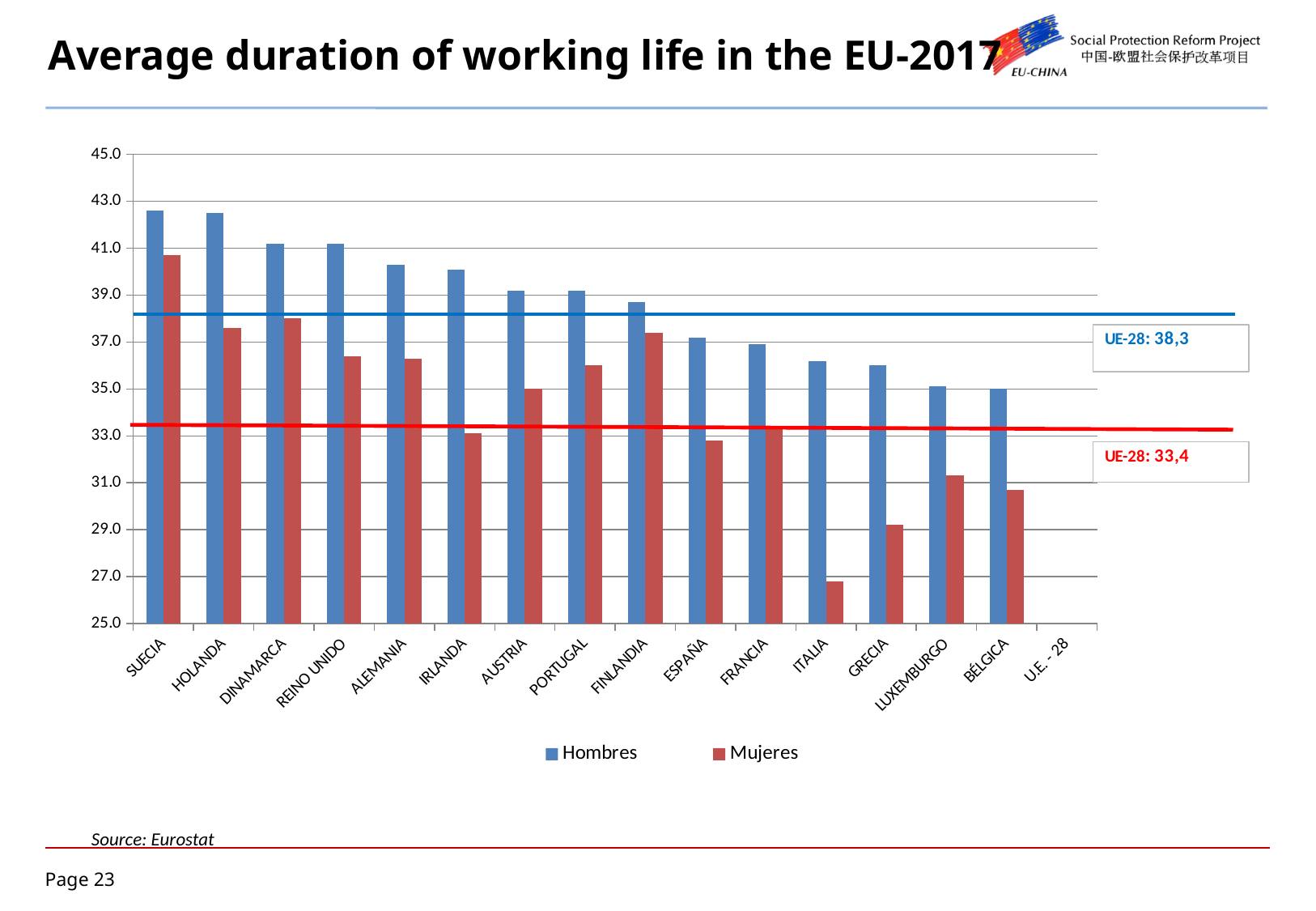
What are the two series named in the legend? Hombres and Mujeres Is the Hombres value for SUECIA greater or less than 41.0? greater Which country has the highest Mujeres value? SUECIA What is the UE-28 value shown for the red (Mujeres) reference line? 33,4 What kind of chart is shown on the slide? bar chart Do the Hombres values generally rise or fall from left to right across the countries? fall What is the UE-28 value shown for the blue (Hombres) reference line? 38,3 Is the Mujeres value for GRECIA greater or less than 31.0? less Which country has the lowest Mujeres value? ITALIA In ITALIA, which is larger, the Hombres value or the Mujeres value? Hombres How many series does the legend list? 2 What is the difference between the UE-28 value for Hombres (38,3) and the UE-28 value for Mujeres (33,4)? 4,9